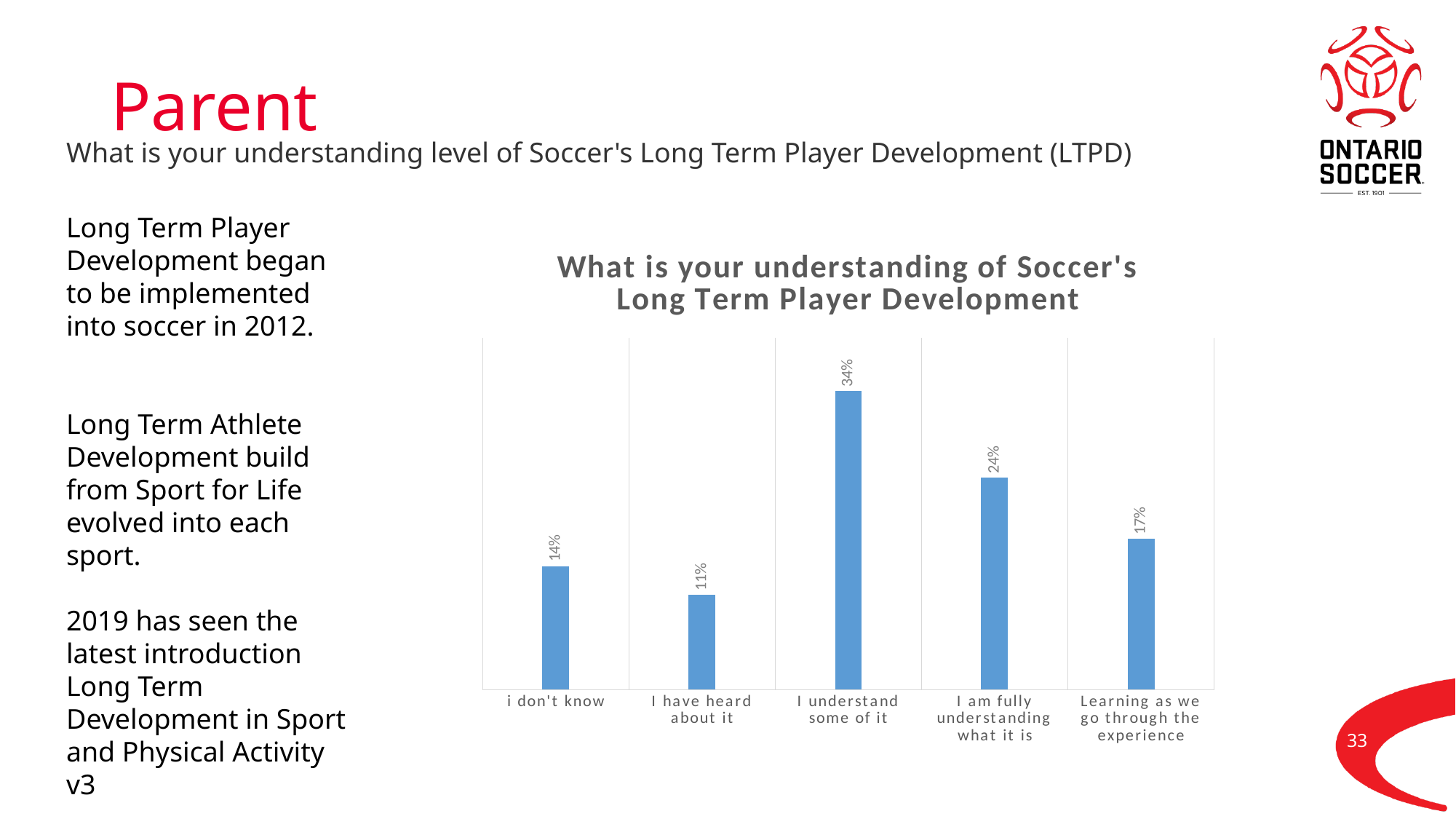
What is the value for "I am fully understanding what it is"? 24% How many categories are shown in the chart? 5 Which category has the highest value? I understand some of it What kind of chart is shown on the slide? Bar chart What is the difference between "Learning as we go through the experience" and "i don't know"? 3% What percentage of parents answered "Learning as we go through the experience"? 17% What percentage of parents answered "I understand some of it"? 34% What is the difference between "I understand some of it" and "I am fully understanding what it is"? 10% Which is larger: "i don't know" or "I have heard about it"? i don't know What is the title of the chart? What is your understanding of Soccer's Long Term Player Development What is the value for "I have heard about it"? 11% Which category has the lowest value? I have heard about it